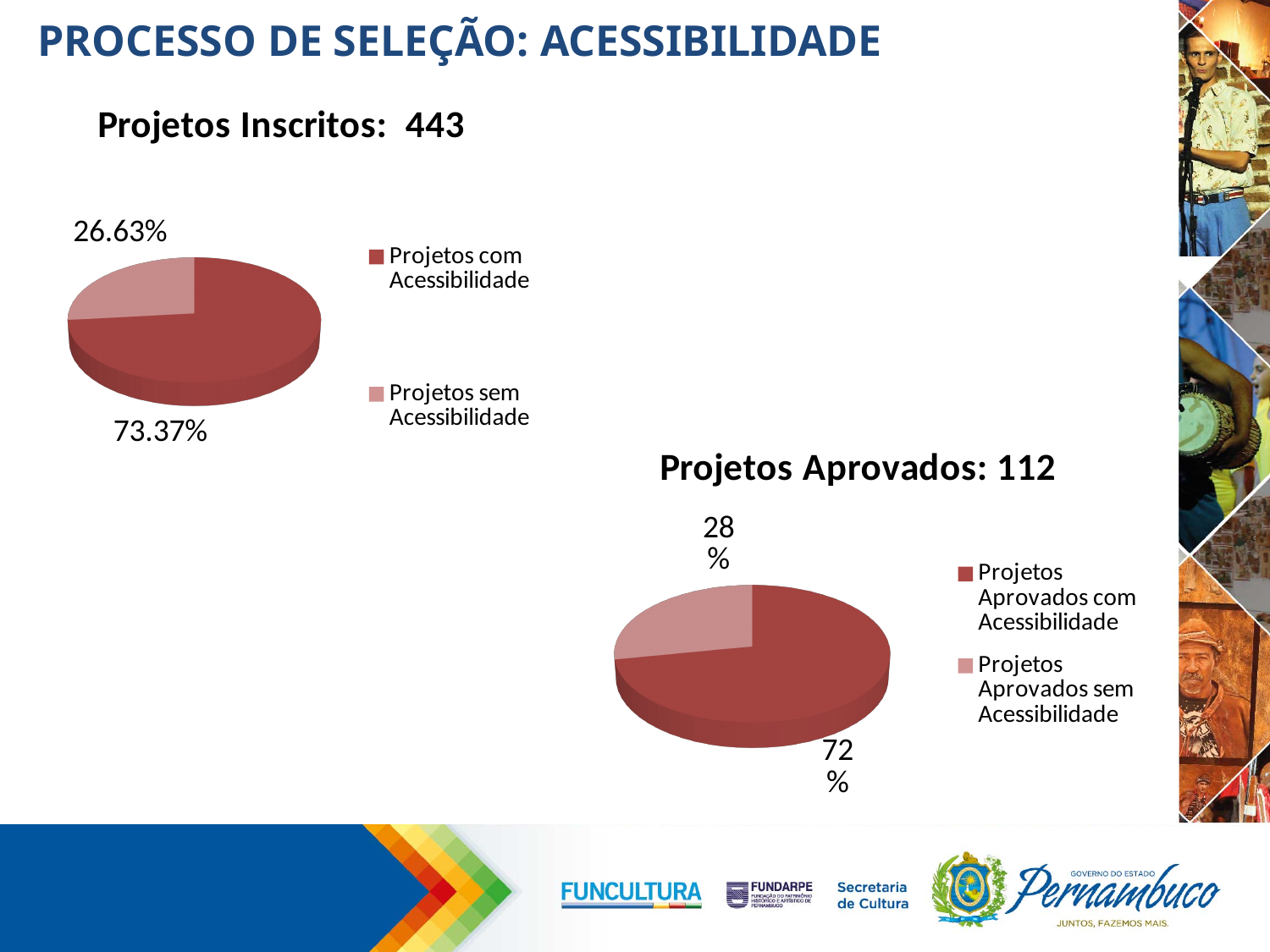
In the 'Projetos Aprovados: 112' chart, which slice is the smallest? Projetos Aprovados sem Acessibilidade Which is larger: the 'sem Acessibilidade' share in the 'Projetos Inscritos' chart or the 'sem Acessibilidade' share in the 'Projetos Aprovados' chart? Projetos Aprovados (28%) In the 'Projetos Aprovados: 112' chart, what share is labelled 'Projetos Aprovados com Acessibilidade'? 72% In the 'Projetos Aprovados: 112' chart, what is the difference in percentage points between the 'com Acessibilidade' and 'sem Acessibilidade' slices? 44 percentage points What type of chart is used for 'Projetos Inscritos: 443'? Pie chart In the 'Projetos Inscritos: 443' chart, what share of projects is labelled 'Projetos sem Acessibilidade'? 26.63% How many slices does the 'Projetos Aprovados: 112' chart have? 2 How many entries does the legend of the 'Projetos Inscritos: 443' chart list? 2 In the 'Projetos Aprovados: 112' chart, what share is labelled 'Projetos Aprovados sem Acessibilidade'? 28% In the 'Projetos Inscritos: 443' chart, what share of projects is labelled 'Projetos com Acessibilidade'? 73.37% In the 'Projetos Inscritos: 443' chart, which slice is the largest? Projetos com Acessibilidade In the 'Projetos Inscritos: 443' chart, what is the difference in percentage points between the 'com Acessibilidade' and 'sem Acessibilidade' slices? 46.74 percentage points